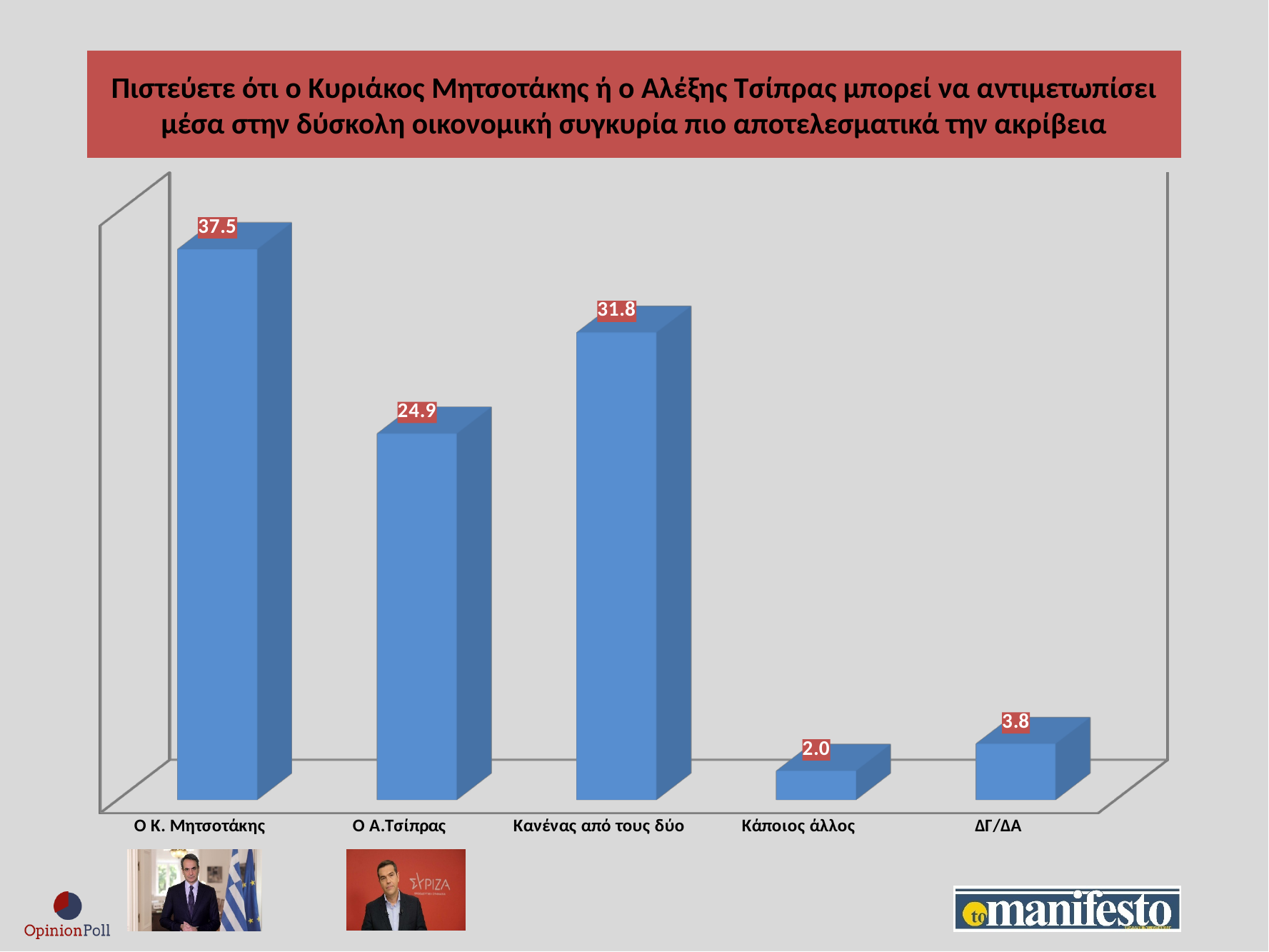
What kind of chart is shown on the slide? Bar chart What is the value for Κανένας από τους δύο? 31.8 Which is larger, the value for Ο Α.Τσίπρας or the value for Κανένας από τους δύο? Κανένας από τους δύο What is the value for Ο Α.Τσίπρας? 24.9 Which category has the highest value? Ο Κ. Μητσοτάκης How many categories are shown in the chart? 5 What is the value for Ο Κ. Μητσοτάκης? 37.5 What is the difference between the values for Ο Κ. Μητσοτάκης and Ο Α.Τσίπρας? 12.6 What is the difference between the values for ΔΓ/ΔΑ and Κάποιος άλλος? 1.8 Which category has the lowest value? Κάποιος άλλος What is the value for Κάποιος άλλος? 2.0 What is the value for ΔΓ/ΔΑ? 3.8